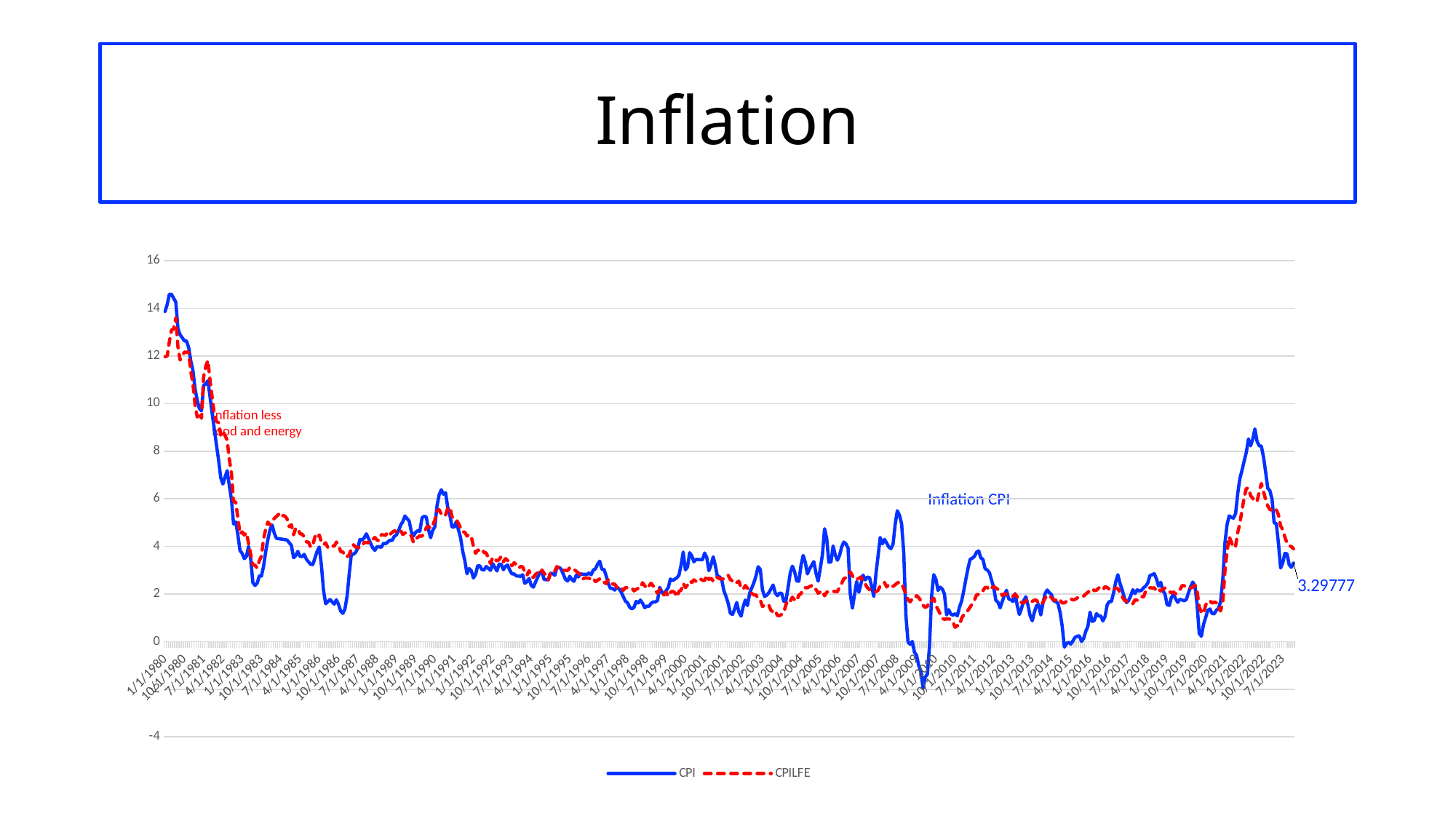
Is the peak CPI value in 2022 greater or less than 8? greater What kind of chart is shown on the slide? line chart What is the value shown by the data label at the end of the CPI line? 3.29777 Is the lowest CPI value around 2009 greater or less than 0? less How many series does the legend list? 2 What are the two series named in the legend? CPI and CPILFE Is the peak CPILFE value in 2022 greater or less than 8? less At 1/1/1980, which series has the higher value, CPI or CPILFE? CPI Which series reaches the highest value anywhere on the chart? CPI Which series is drawn as a red dashed line? CPILFE Does the CPI line rise or fall between 1/1/1980 and 1/1/1983? fall